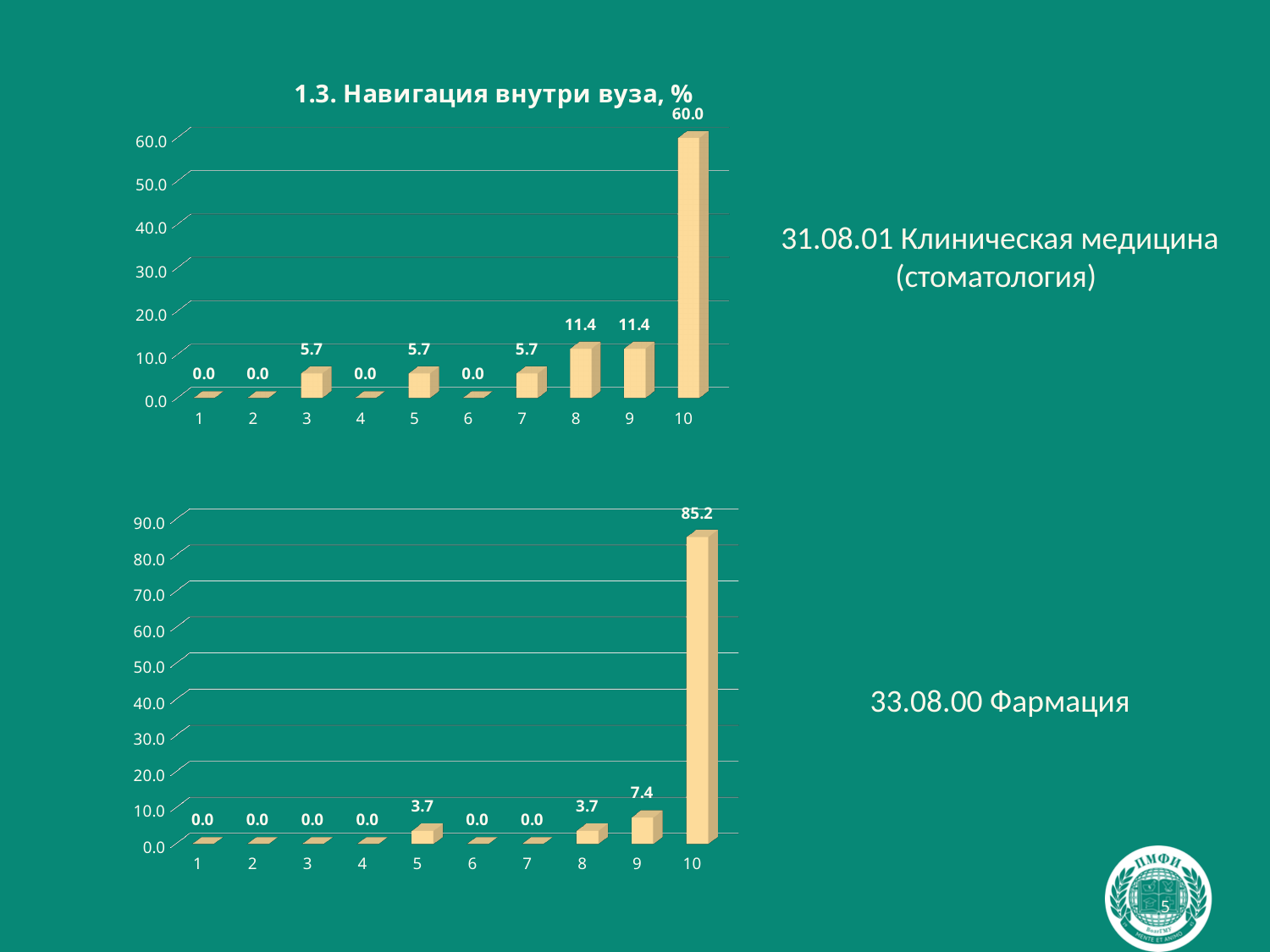
In the top chart (1.3. Навигация внутри вуза, %), what is the value for category 8? 11.4 What is the title of the top chart? 1.3. Навигация внутри вуза, % What kind of chart is the bottom chart (33.08.00 Фармация)? bar chart In the top chart (1.3. Навигация внутри вуза, %), what is the difference between the values for category 10 and category 9? 48.6 In the top chart (1.3. Навигация внутри вуза, %), how many categories are shown on the x axis? 10 In the top chart (1.3. Навигация внутри вуза, %), what is the value for category 3? 5.7 In the top chart (1.3. Навигация внутри вуза, %), which category has the highest value? 10 In the top chart (1.3. Навигация внутри вуза, %), what is the value for category 10? 60.0 In the bottom chart (33.08.00 Фармация), which is larger, the value for category 9 or category 8? category 9 In the bottom chart (33.08.00 Фармация), what is the difference between the values for category 9 and category 5? 3.7 In the bottom chart (33.08.00 Фармация), what is the value for category 9? 7.4 In the bottom chart (33.08.00 Фармация), what is the value for category 10? 85.2